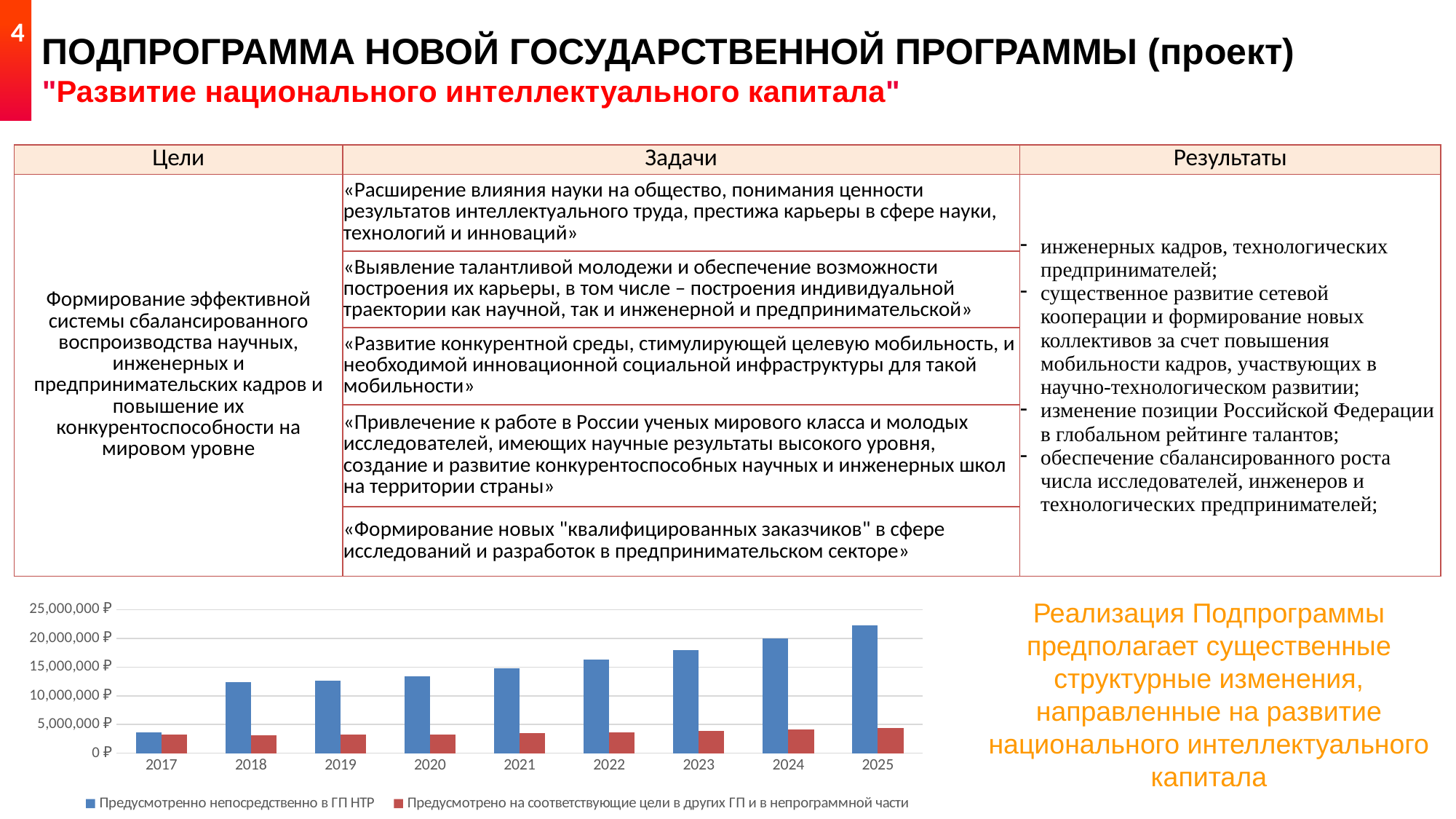
Is the 2023 value for «Предусмотренно непосредственно в ГП НТР» greater or less than 15,000,000 ₽? greater Which colour represents «Предусмотрено на соответствующие цели в других ГП и в непрограммной части» in the chart? red How many series does the chart legend list? 2 Is the 2025 value for «Предусмотрено на соответствующие цели в других ГП и в непрограммной части» greater or less than 5,000,000 ₽? less Is the 2017 value for «Предусмотренно непосредственно в ГП НТР» greater or less than 5,000,000 ₽? less In which year is the value for «Предусмотренно непосредственно в ГП НТР» the lowest? 2017 Do the values for «Предусмотренно непосредственно в ГП НТР» rise or fall from 2017 to 2025? rise What kind of chart is shown at the bottom of the slide? bar chart In which year is the value for «Предусмотренно непосредственно в ГП НТР» the highest? 2025 In 2025, which series has the larger value: «Предусмотренно непосредственно в ГП НТР» or «Предусмотрено на соответствующие цели в других ГП и в непрограммной части»? Предусмотренно непосредственно в ГП НТР How many years are shown on the x axis of the chart? 9